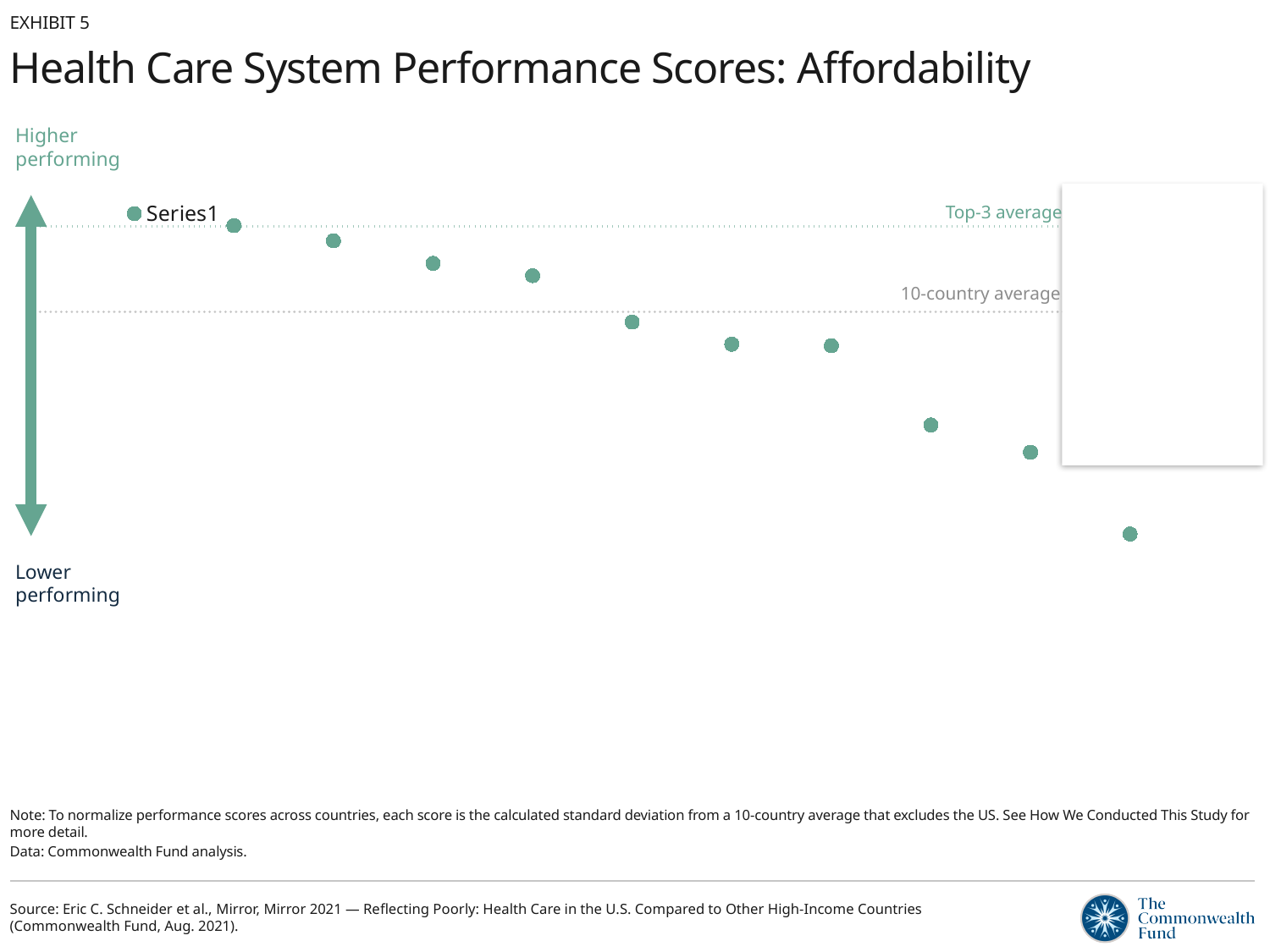
How many data points lie below the 10-country average line? 6 Is the rightmost data point above or below the 10-country average line? Below How many series does the legend list? 1 Do the plotted values rise or fall from left to right across the chart? Fall What is the name of the series shown in the legend? Series1 Is the leftmost data point above or below the 10-country average line? Above Which reference line is positioned higher on the chart, the Top-3 average or the 10-country average? Top-3 average What is the title of the chart? Health Care System Performance Scores: Affordability What kind of chart is shown on the slide? Scatter (dot) chart